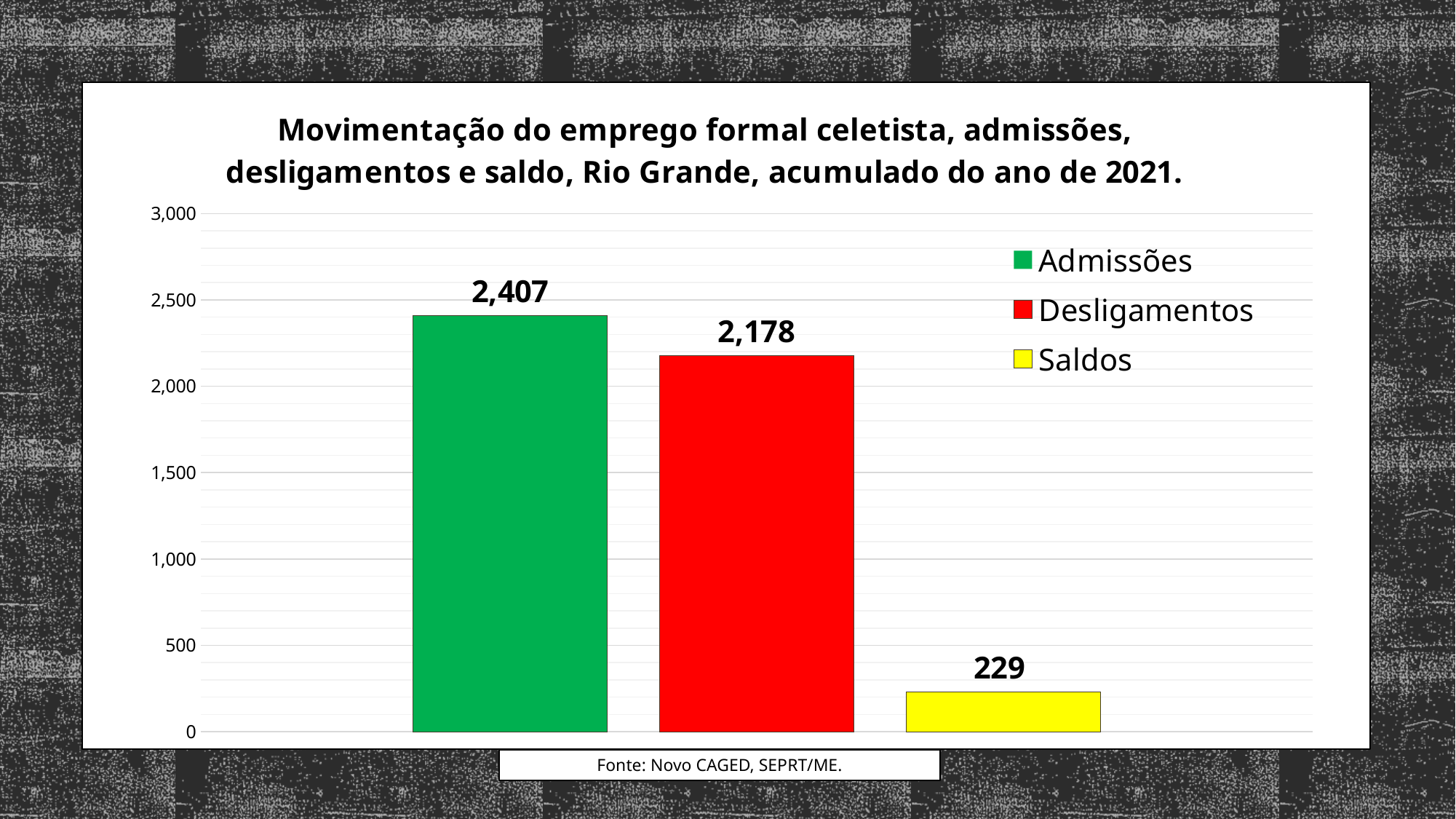
What is the value for Admissões? 2,407 Which is larger, Admissões or Desligamentos? Admissões What is the difference between Admissões and Desligamentos? 229 Which series has the highest value? Admissões What kind of chart is shown? Bar chart Is the value for Saldos greater or less than 500? less Which series has the lowest value? Saldos What is the value for Desligamentos? 2,178 How many series does the legend list? 3 What is the value for Saldos? 229 Is the value for Desligamentos greater or less than 2,000? greater What colour is the bar for Saldos? Yellow